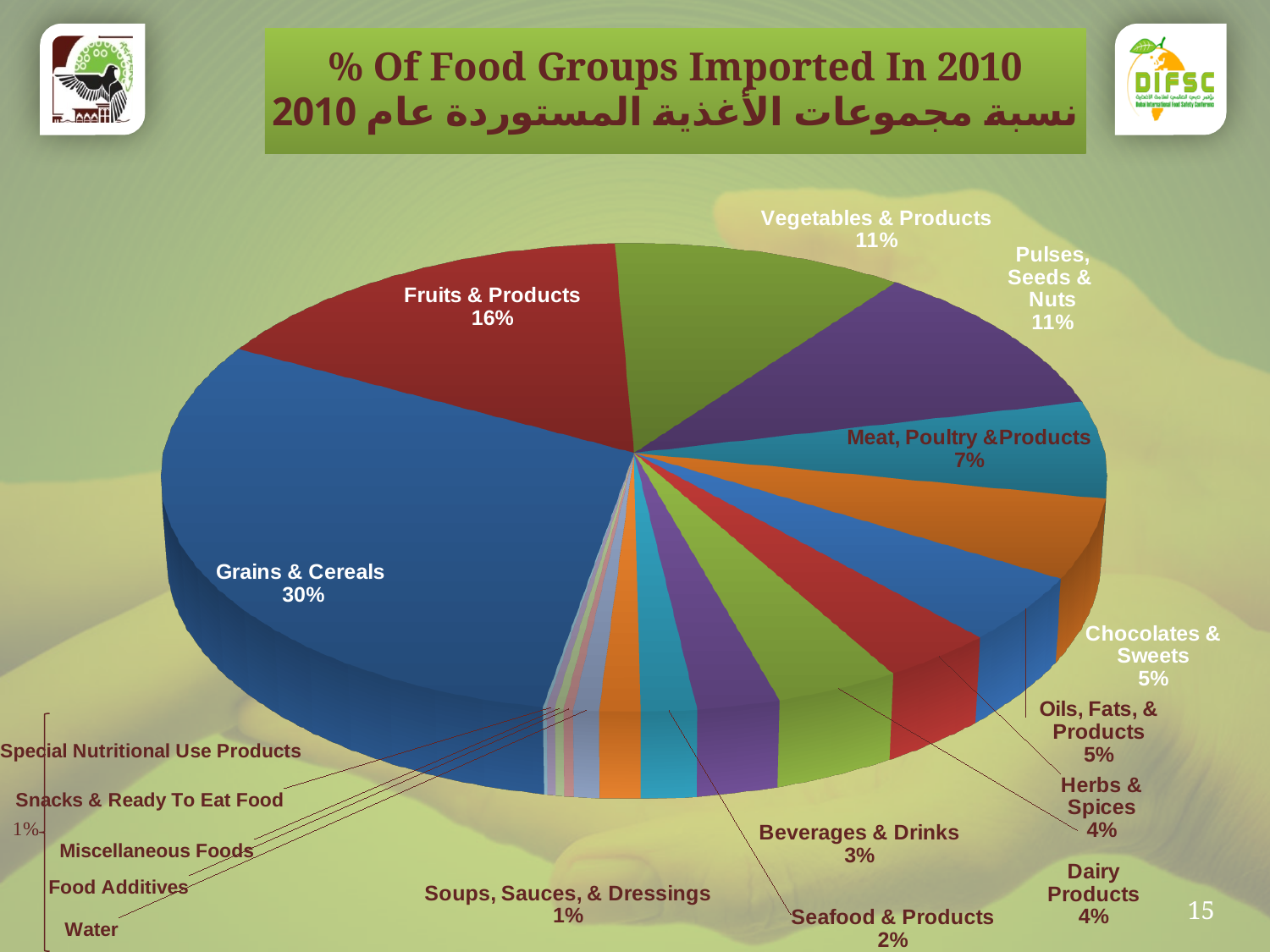
What percentage is shown for Pulses, Seeds & Nuts? 11% What percentage is shown for Seafood & Products? 2% What percentage is shown for Beverages & Drinks? 3% What is the combined percentage of Chocolates & Sweets and Oils, Fats, & Products? 10% What percentage of food groups imported in 2010 was Grains & Cereals? 30% What share of the pie is Fruits & Products? 16% Which is larger, the share for Vegetables & Products or the share for Meat, Poultry & Products? Vegetables & Products What is the title of the chart? % Of Food Groups Imported In 2010 Which food group has the largest share of imports in 2010? Grains & Cereals What kind of chart is shown on the slide? Pie chart What is the difference in percentage points between Grains & Cereals and Fruits & Products? 14 What percentage is shown for Meat, Poultry & Products? 7%